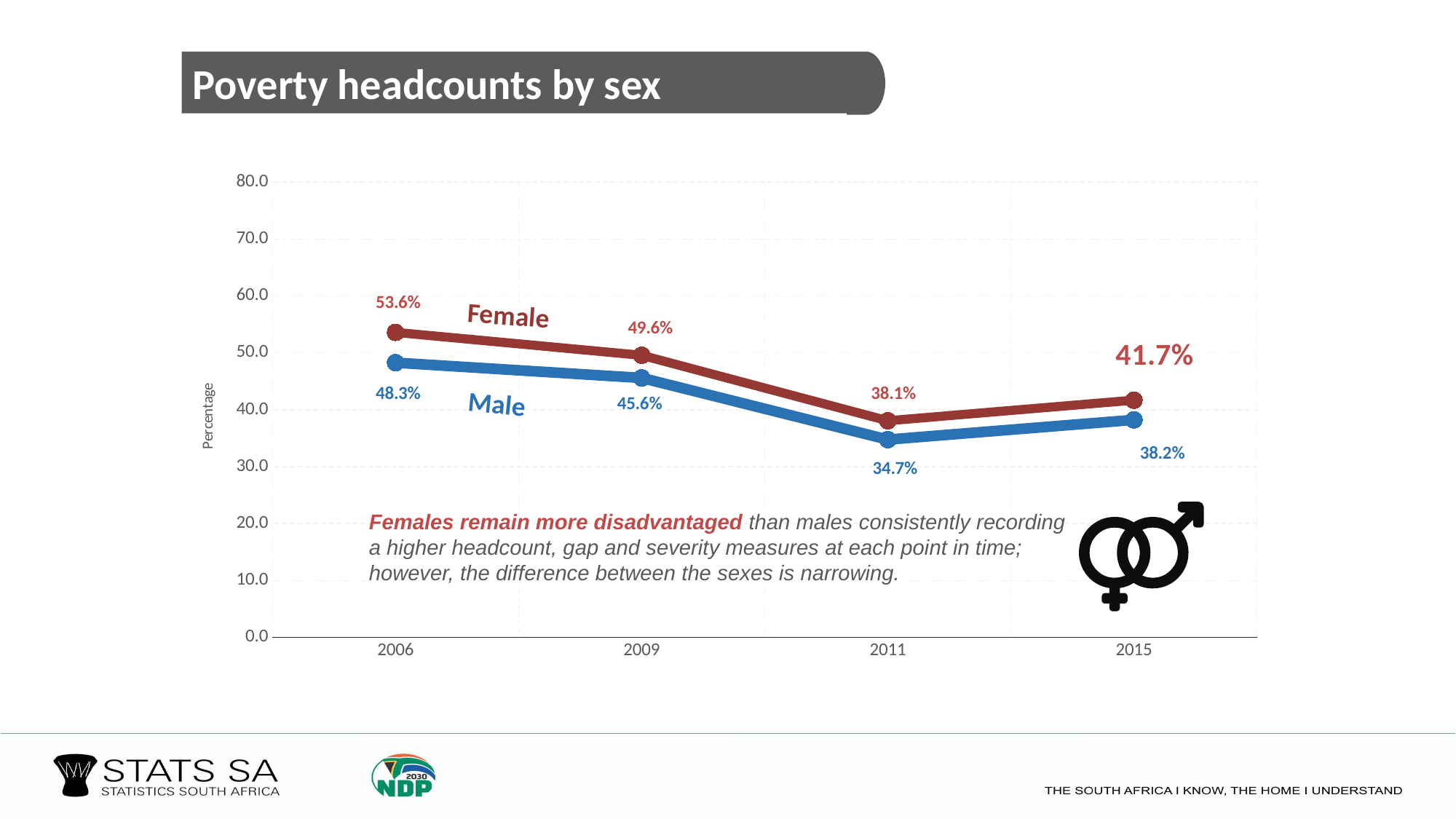
Did the male poverty headcount rise or fall between 2006 and 2011? Fall Which was higher in 2009, the female or the male poverty headcount? Female What was the male poverty headcount in 2011? 34.7% In which year was the female poverty headcount lowest? 2011 What was the female poverty headcount in 2015? 41.7% What is the difference between the female and male poverty headcounts in 2006? 5.3 percentage points How many years are shown on the x axis? 4 What was the male poverty headcount in 2009? 45.6% What kind of chart is shown on the slide? Line chart In which year was the male poverty headcount highest? 2006 What is the difference between the female and male poverty headcounts in 2015? 3.5 percentage points What was the female poverty headcount in 2006? 53.6%